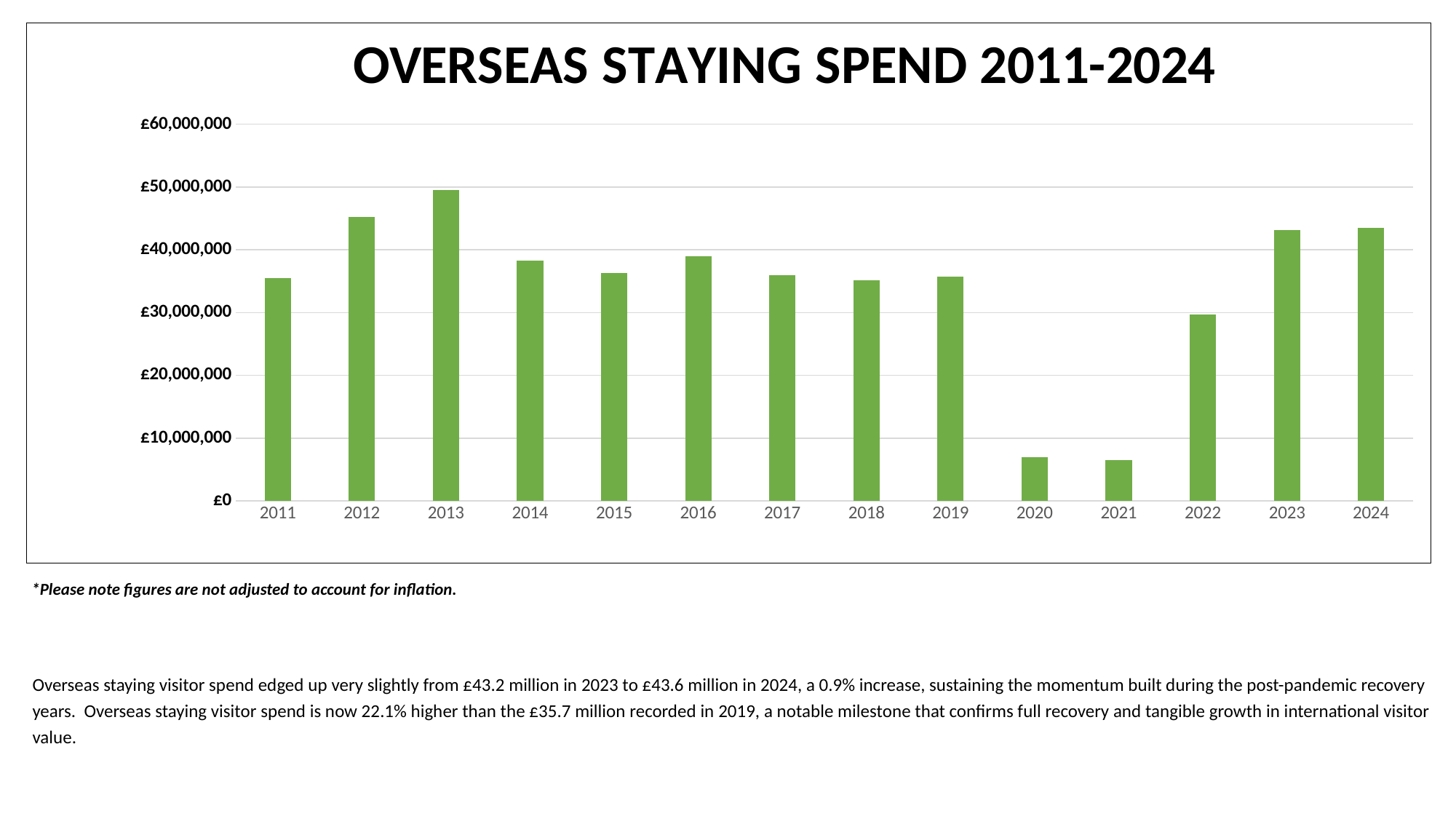
How many years are plotted on the chart? 14 Is the value for 2013 greater or less than £40,000,000? greater Is the value for 2014 greater or less than £40,000,000? less What kind of chart is shown on the slide? bar chart Is the value for 2011 greater or less than £30,000,000? greater Which is larger, the spend in 2016 or in 2018? 2016 Which is larger, the spend in 2012 or in 2011? 2012 Do the values rise or fall from 2011 to 2013? rise What is the title of the chart? OVERSEAS STAYING SPEND 2011-2024 Which year has the highest overseas staying spend? 2013 Do the values rise or fall from 2019 to 2021? fall